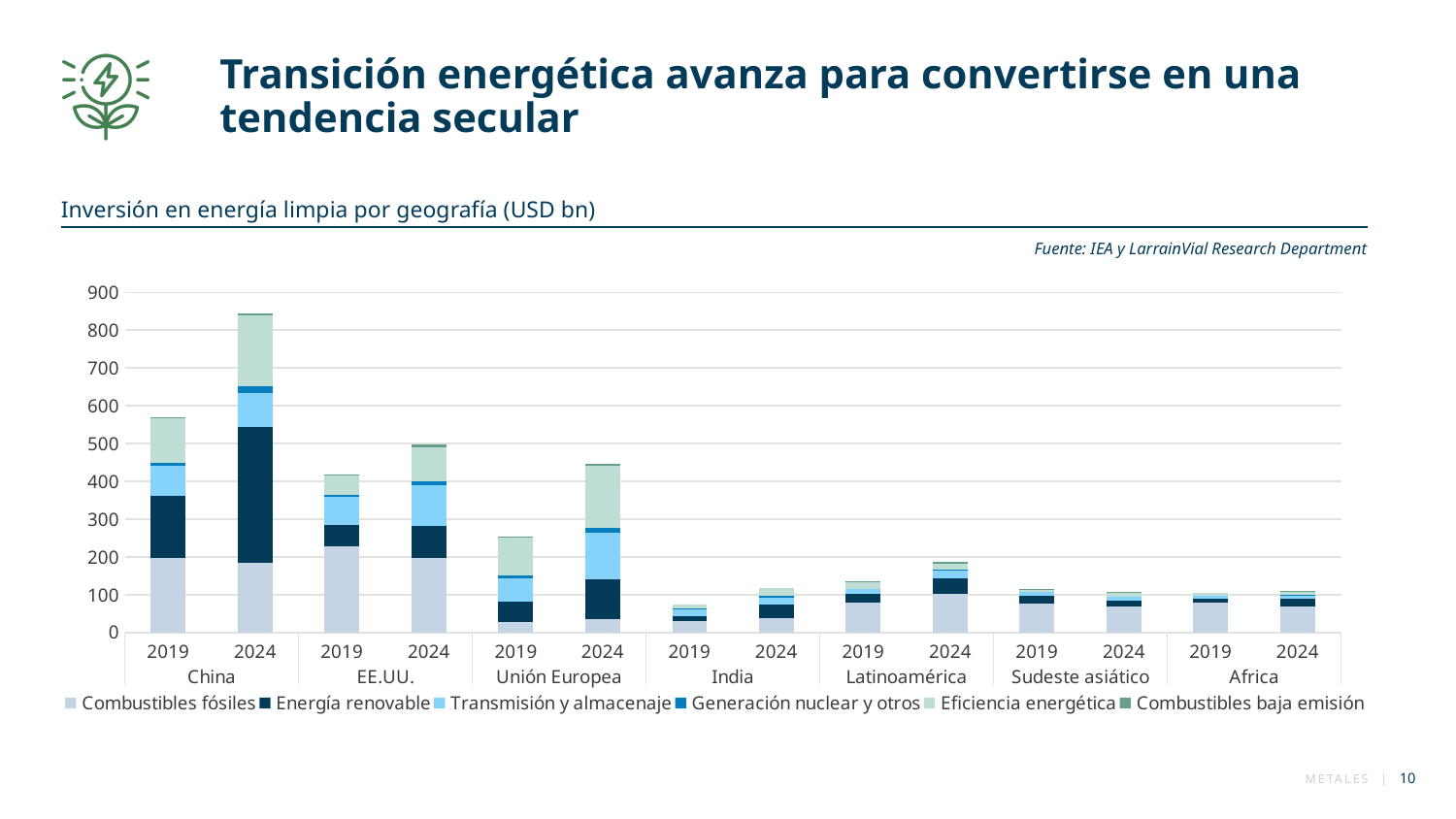
Is the total value for China 2019 greater or less than 600? less What kind of chart is shown on the slide? stacked bar chart Is the total value for India 2019 greater or less than 100? less Does the total investment for China rise or fall from 2019 to 2024? rise Which is larger, the total for EE.UU. 2024 or the total for Unión Europea 2024? EE.UU. 2024 Is the total value for Unión Europea 2024 greater or less than 400? greater How many bars are plotted in the chart? 14 What is the title of the chart? Inversión en energía limpia por geografía (USD bn) Which bar has the highest total value? China 2024 How many series does the legend list? 6 Which bar has the lowest total value? India 2019